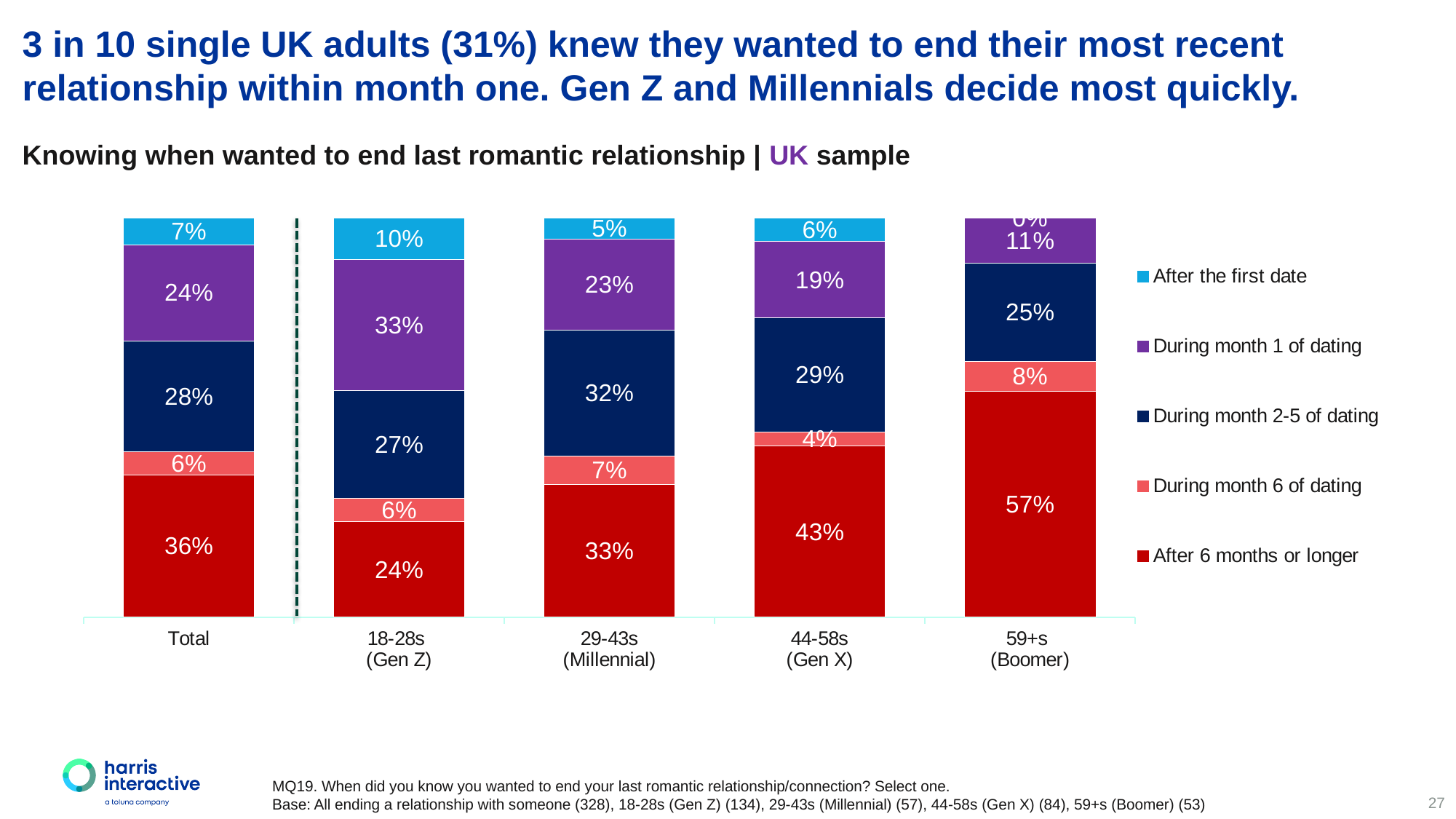
How many age groups (including Total) are shown on the x axis? 5 How many series does the legend list? 5 What is the value for 'During month 2-5 of dating' for 29-43s (Millennial)? 32% Which series is shown in red at the bottom of each bar? After 6 months or longer What percentage of the Total sample knew they wanted to end the relationship after 6 months or longer? 36% What is the value for 'During month 1 of dating' for 18-28s (Gen Z)? 33% Which is larger: the 'During month 6 of dating' value for 59+s (Boomer) or for 44-58s (Gen X)? 59+s (Boomer) Which age group has the highest value for 'After 6 months or longer'? 59+s (Boomer) What is the difference between the 'After 6 months or longer' values for 59+s (Boomer) and 18-28s (Gen Z)? 33 percentage points Which age group has the lowest value for 'During month 1 of dating'? 59+s (Boomer) What kind of chart is shown on the slide? Stacked bar chart What is the value for 'After the first date' for 44-58s (Gen X)? 6%